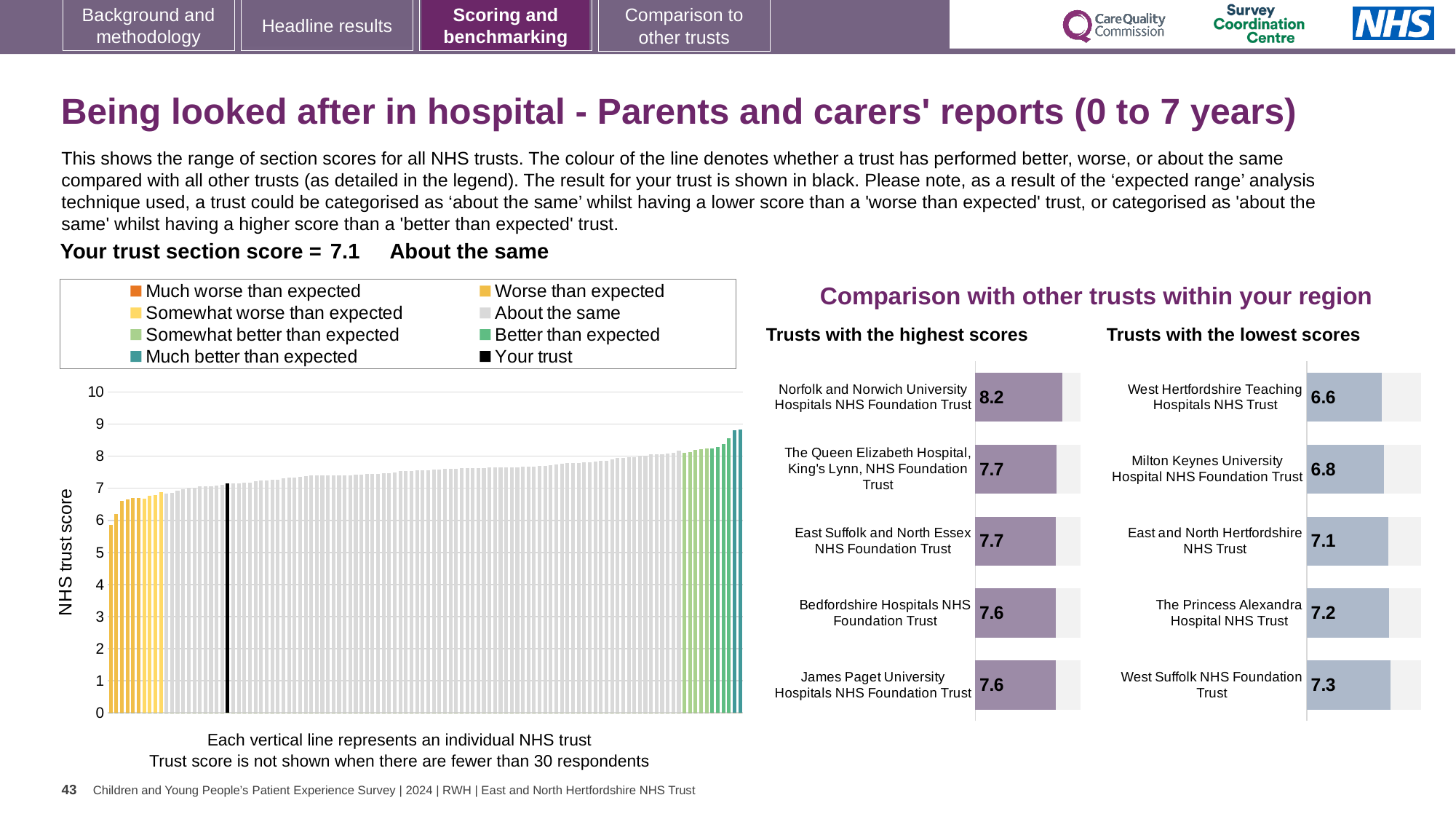
How many entries does the legend of the large chart on the left list? 8 In the 'Trusts with the highest scores' chart, what is the difference between the scores of Norfolk and Norwich University Hospitals NHS Foundation Trust and James Paget University Hospitals NHS Foundation Trust? 0.6 In the 'Trusts with the highest scores' chart, what is the score for Bedfordshire Hospitals NHS Foundation Trust? 7.6 In the large chart on the left, do the trust scores rise or fall from left to right? Rise In the 'Trusts with the lowest scores' chart, which has the higher score: Milton Keynes University Hospital NHS Foundation Trust or The Princess Alexandra Hospital NHS Trust? The Princess Alexandra Hospital NHS Trust In the 'Trusts with the lowest scores' chart, what is the difference between the scores of West Suffolk NHS Foundation Trust and West Hertfordshire Teaching Hospitals NHS Trust? 0.7 In the 'Trusts with the highest scores' chart, how many trusts are listed? 5 What type of chart is the large chart on the left showing NHS trust scores? Bar chart In the 'Trusts with the lowest scores' chart, which trust has the lowest score? West Hertfordshire Teaching Hospitals NHS Trust In the 'Trusts with the highest scores' chart, what is the score for Norfolk and Norwich University Hospitals NHS Foundation Trust? 8.2 In the 'Trusts with the highest scores' chart, which trust has the highest score? Norfolk and Norwich University Hospitals NHS Foundation Trust In the 'Trusts with the lowest scores' chart, what is the score for Milton Keynes University Hospital NHS Foundation Trust? 6.8